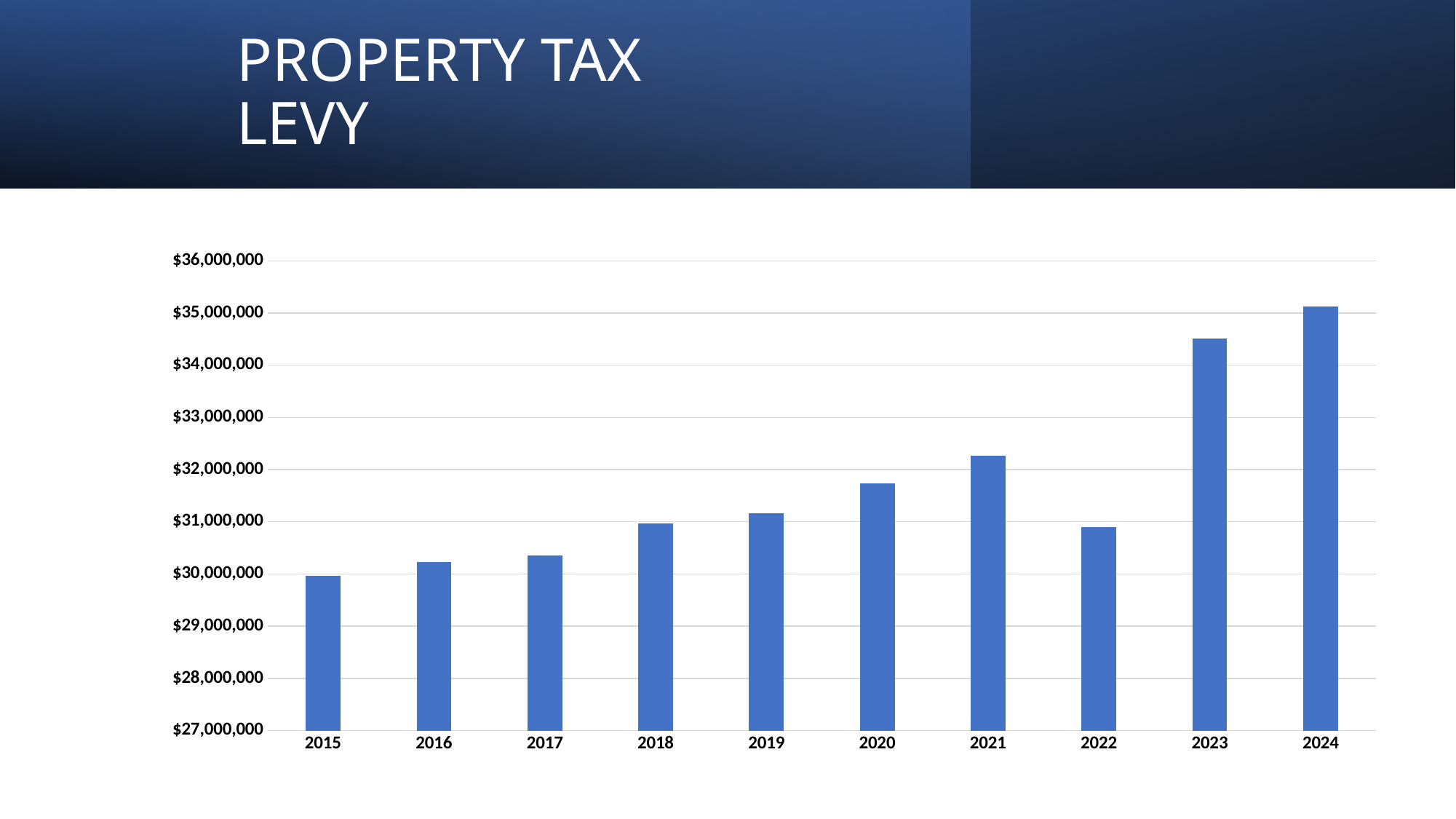
Do the values generally rise or fall from 2015 to 2021? rise Is the value for 2023 greater or less than $34,000,000? greater What kind of chart is shown on the slide? Bar chart Which year has the highest property tax levy? 2024 Which is larger, the value for 2021 or the value for 2022? 2021 Which is larger, the value for 2020 or the value for 2023? 2023 What is the title of the slide containing the chart? PROPERTY TAX LEVY Is the value for 2017 greater or less than $30,000,000? greater Is the value for 2020 greater or less than $32,000,000? less Which year has the lowest property tax levy? 2015 How many years are shown on the x axis? 10